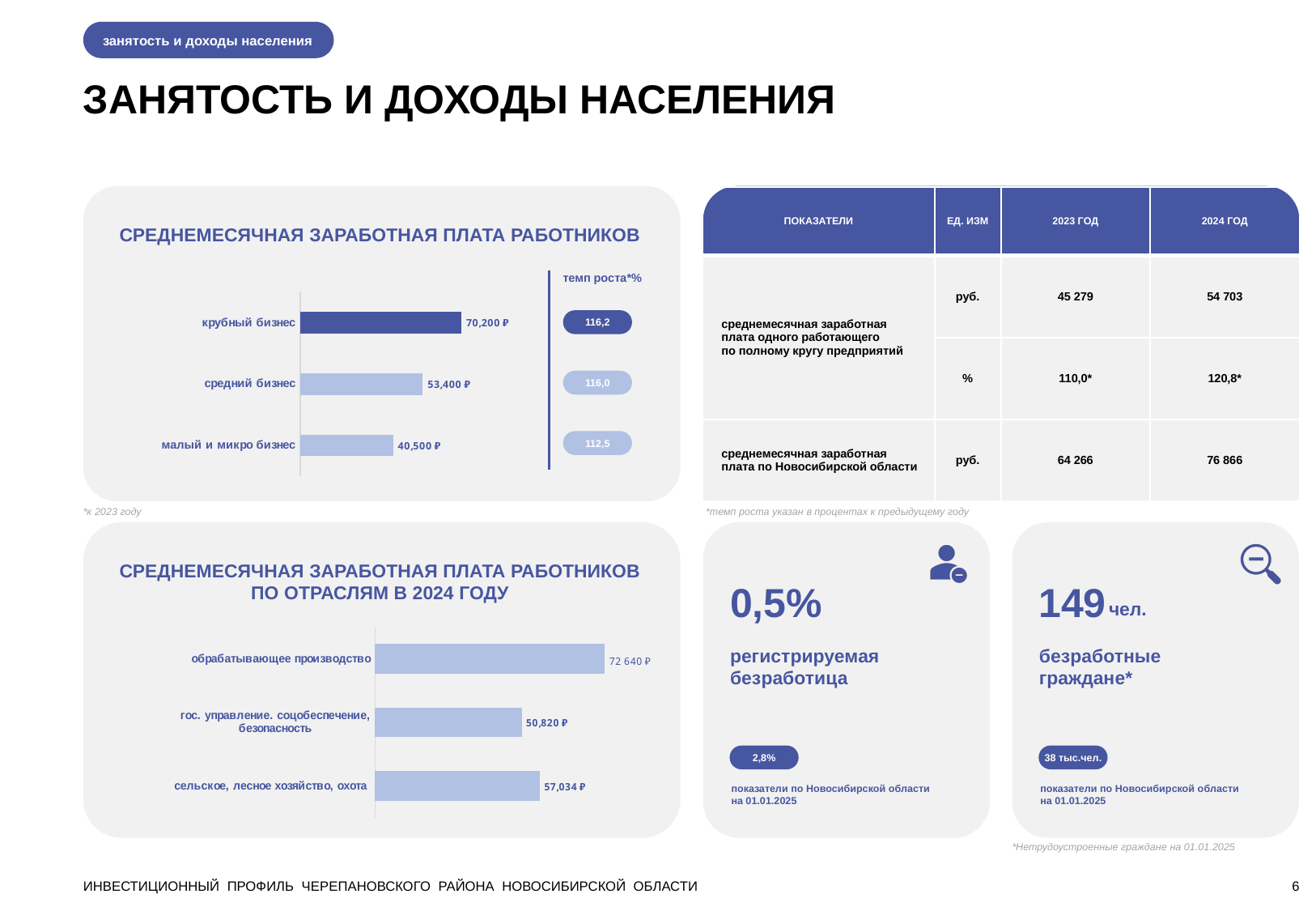
In the chart 'СРЕДНЕМЕСЯЧНАЯ ЗАРАБОТНАЯ ПЛАТА РАБОТНИКОВ', what is the value for 'малый и микро бизнес'? 40,500 ₽ In the chart 'СРЕДНЕМЕСЯЧНАЯ ЗАРАБОТНАЯ ПЛАТА РАБОТНИКОВ', what growth rate (темп роста) is shown for 'средний бизнес'? 116,0 In the chart 'СРЕДНЕМЕСЯЧНАЯ ЗАРАБОТНАЯ ПЛАТА РАБОТНИКОВ ПО ОТРАСЛЯМ В 2024 ГОДУ', which category has the lowest value? гос. управление, соцобеспечение, безопасность In the chart 'СРЕДНЕМЕСЯЧНАЯ ЗАРАБОТНАЯ ПЛАТА РАБОТНИКОВ', what is the difference between 'крупный бизнес' and 'средний бизнес'? 16,800 ₽ In the chart 'СРЕДНЕМЕСЯЧНАЯ ЗАРАБОТНАЯ ПЛАТА РАБОТНИКОВ', what is the value for 'крупный бизнес'? 70,200 ₽ In the chart 'СРЕДНЕМЕСЯЧНАЯ ЗАРАБОТНАЯ ПЛАТА РАБОТНИКОВ', how many categories are shown? 3 In the chart 'СРЕДНЕМЕСЯЧНАЯ ЗАРАБОТНАЯ ПЛАТА РАБОТНИКОВ', which category has the highest value? крубный бизнес In the chart 'СРЕДНЕМЕСЯЧНАЯ ЗАРАБОТНАЯ ПЛАТА РАБОТНИКОВ ПО ОТРАСЛЯМ В 2024 ГОДУ', what is the value for 'сельское, лесное хозяйство, охота'? 57,034 ₽ In the chart 'СРЕДНЕМЕСЯЧНАЯ ЗАРАБОТНАЯ ПЛАТА РАБОТНИКОВ ПО ОТРАСЛЯМ В 2024 ГОДУ', what is the value for 'обрабатывающее производство'? 72 640 ₽ In the chart 'СРЕДНЕМЕСЯЧНАЯ ЗАРАБОТНАЯ ПЛАТА РАБОТНИКОВ ПО ОТРАСЛЯМ В 2024 ГОДУ', which is larger: 'сельское, лесное хозяйство, охота' or 'гос. управление, соцобеспечение, безопасность'? сельское, лесное хозяйство, охота In the chart 'СРЕДНЕМЕСЯЧНАЯ ЗАРАБОТНАЯ ПЛАТА РАБОТНИКОВ', which category has the lowest value? малый и микро бизнес What kind of chart is 'СРЕДНЕМЕСЯЧНАЯ ЗАРАБОТНАЯ ПЛАТА РАБОТНИКОВ ПО ОТРАСЛЯМ В 2024 ГОДУ'? bar chart